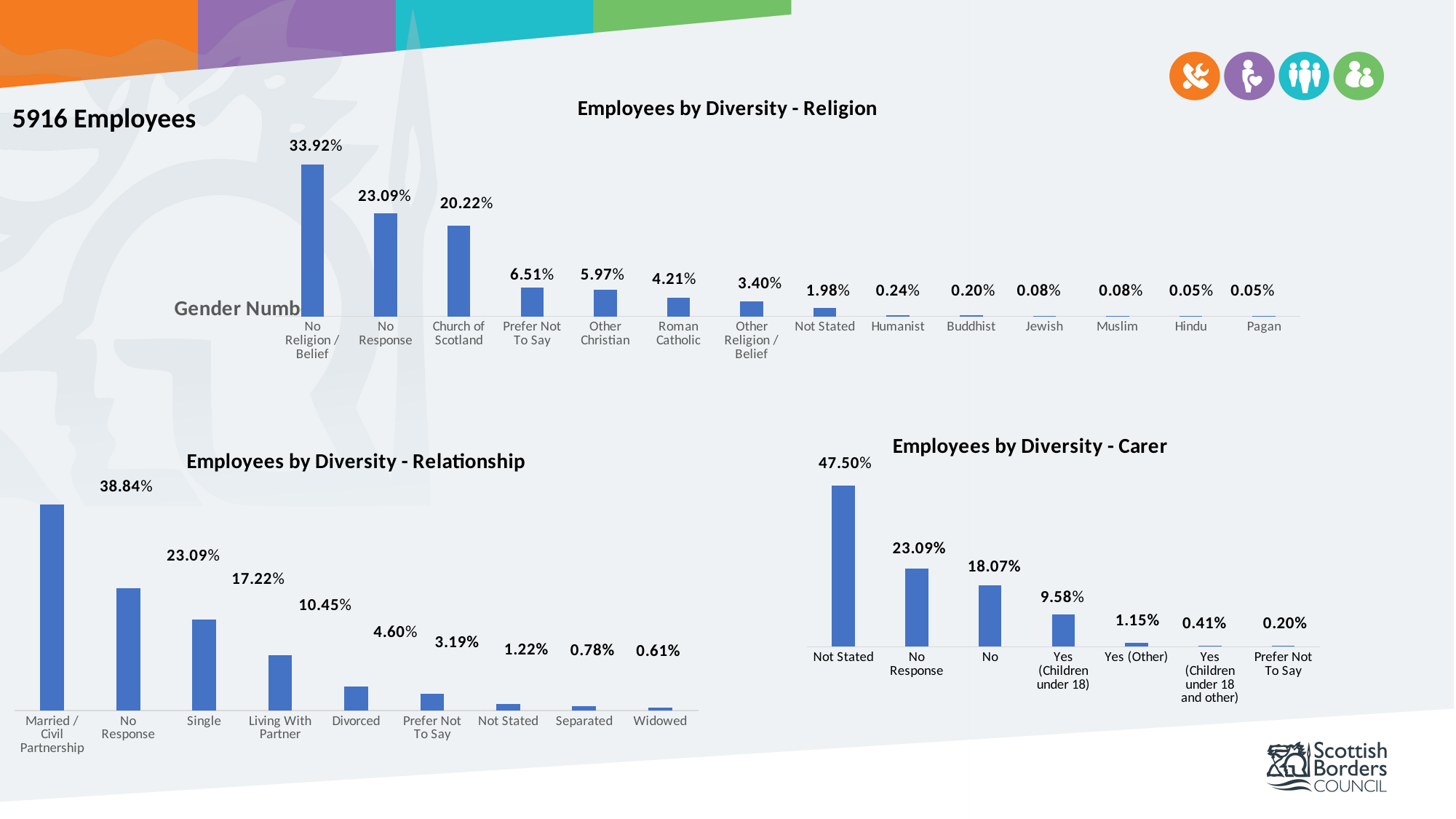
In the 'Employees by Diversity - Relationship' chart, which category has the lowest value? Widowed In the 'Employees by Diversity - Religion' chart, what is the difference between Other Christian and Roman Catholic? 1.76% How many categories are shown in the 'Employees by Diversity - Religion' chart? 14 In the 'Employees by Diversity - Religion' chart, what is the value for Church of Scotland? 20.22% In the 'Employees by Diversity - Relationship' chart, what is the value for Living With Partner? 10.45% In the 'Employees by Diversity - Carer' chart, what is the value for Yes (Children under 18)? 9.58% In the 'Employees by Diversity - Carer' chart, which category has the highest value? Not Stated In the 'Employees by Diversity - Religion' chart, which category has the highest value? No Religion / Belief What type of chart is 'Employees by Diversity - Carer'? Bar chart How many categories are shown in the 'Employees by Diversity - Relationship' chart? 9 In the 'Employees by Diversity - Relationship' chart, what is the difference between Married / Civil Partnership and Single? 21.62% In the 'Employees by Diversity - Religion' chart, which is larger, Prefer Not To Say or Other Religion / Belief? Prefer Not To Say